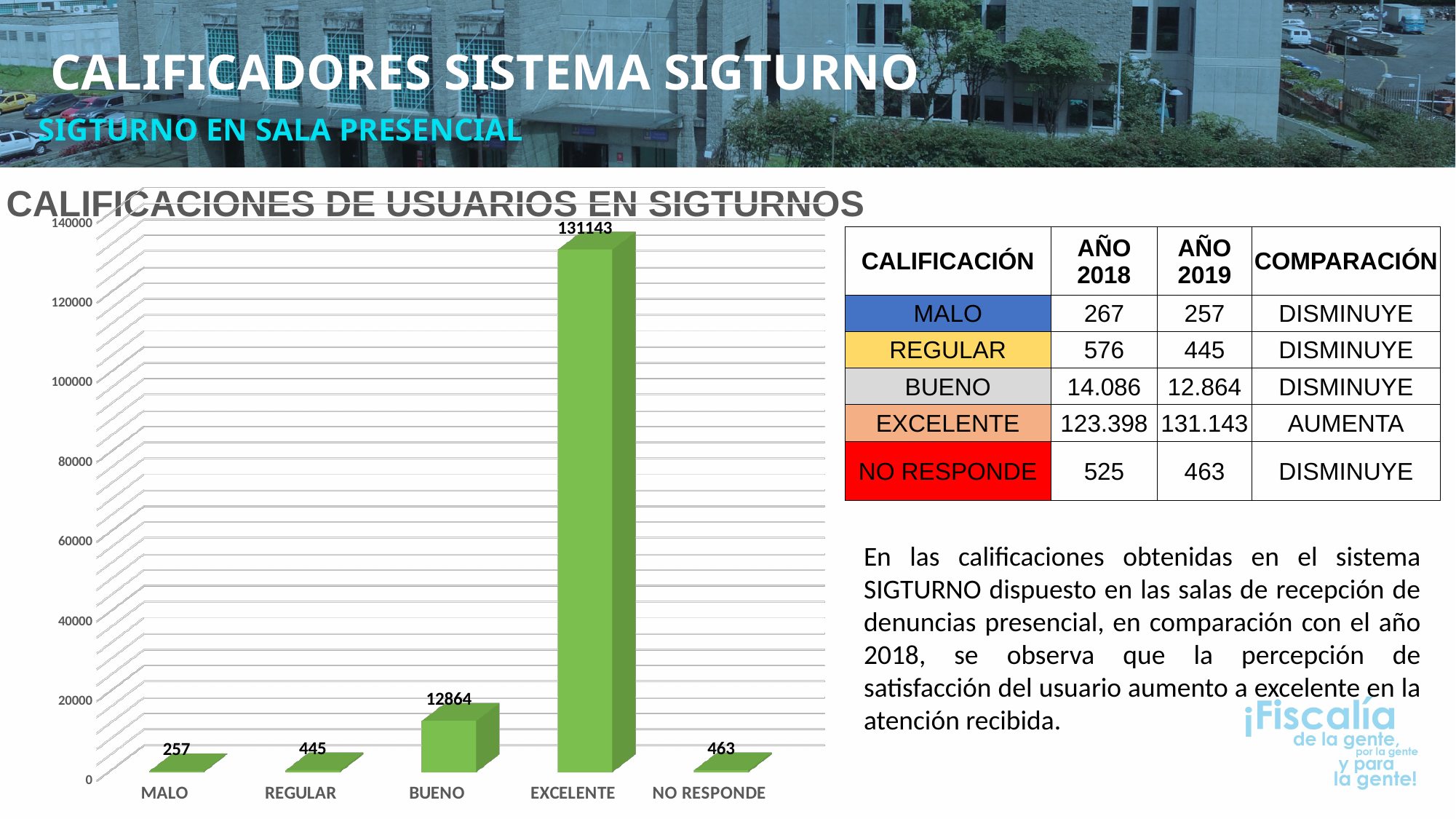
What is the difference between the values for EXCELENTE and BUENO? 118279 Which category has the lowest value in the chart? MALO What is the difference between the values for REGULAR and MALO? 188 Is the value for EXCELENTE greater or less than 120000? greater Which category has the highest value in the chart? EXCELENTE What is the value for NO RESPONDE in the chart? 463 Which is larger, the value for NO RESPONDE or the value for REGULAR? NO RESPONDE What is the value for BUENO in the chart? 12864 How many categories are shown on the x axis of the chart? 5 What is the value for EXCELENTE in the chart? 131143 What is the value for MALO in the chart? 257 What kind of chart is shown on the slide? bar chart